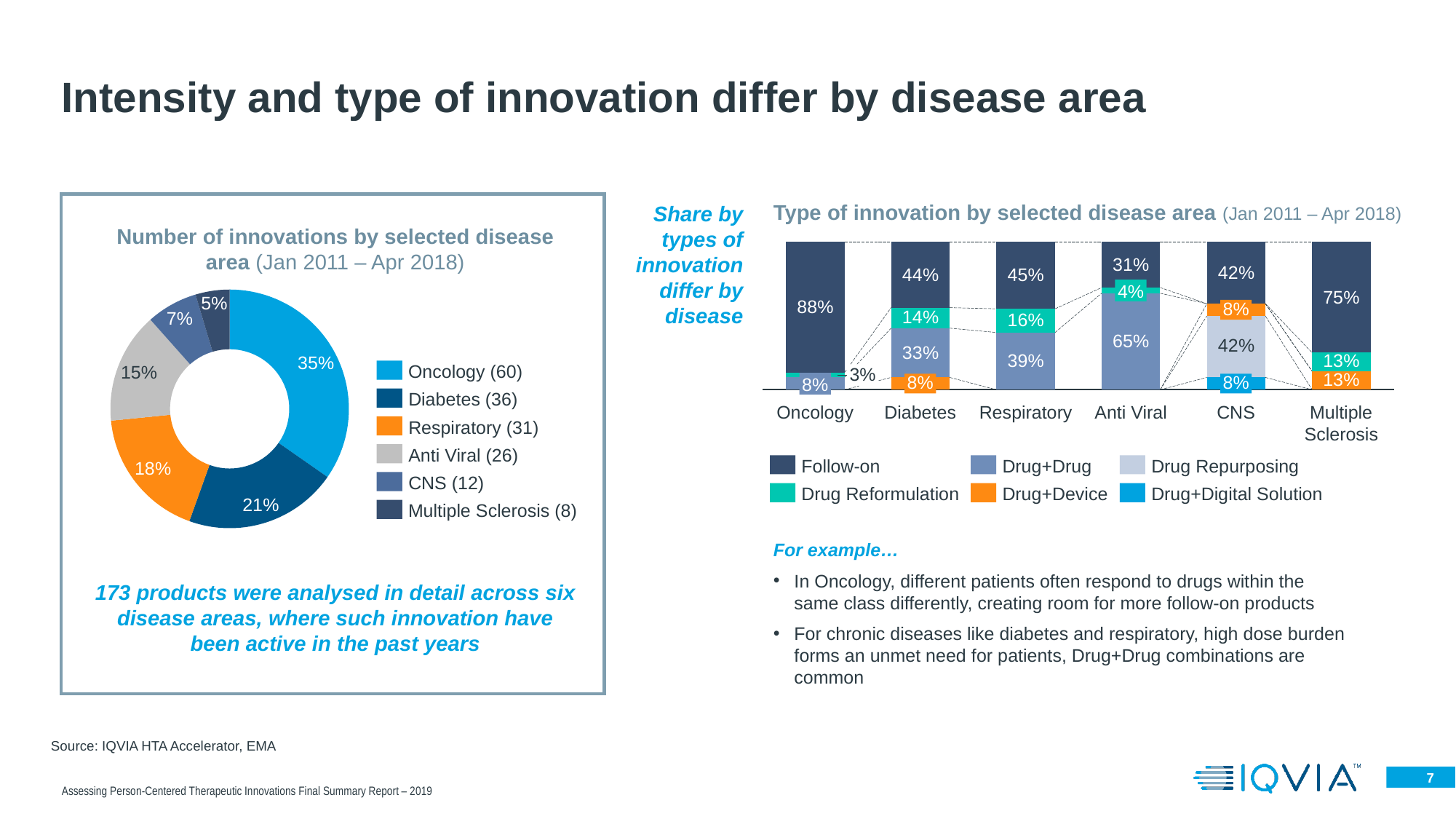
In the 'Number of innovations by selected disease area' chart, which disease area has the smallest share? Multiple Sclerosis How many series does the legend of the 'Type of innovation by selected disease area' chart list? 6 What kind of chart is 'Number of innovations by selected disease area'? Donut (pie) chart In the 'Number of innovations by selected disease area' chart, how many innovations does the legend list for Diabetes? 36 In the 'Type of innovation by selected disease area' chart, which disease area has the lowest Follow-on share? Anti Viral In the 'Type of innovation by selected disease area' chart, what is the Follow-on share for Oncology? 88% In the 'Type of innovation by selected disease area' chart, what is the Drug Repurposing share for CNS? 42% In the 'Number of innovations by selected disease area' chart, what is the difference in percentage points between Respiratory and Anti Viral? 3 percentage points In the 'Type of innovation by selected disease area' chart, what is the Drug+Drug share for Anti Viral? 65% How many disease areas are shown in the 'Number of innovations by selected disease area' chart? 6 In the 'Type of innovation by selected disease area' chart, is the Drug+Drug share larger for Respiratory or for Diabetes? Respiratory In the 'Number of innovations by selected disease area' chart, what share does Oncology have? 35%